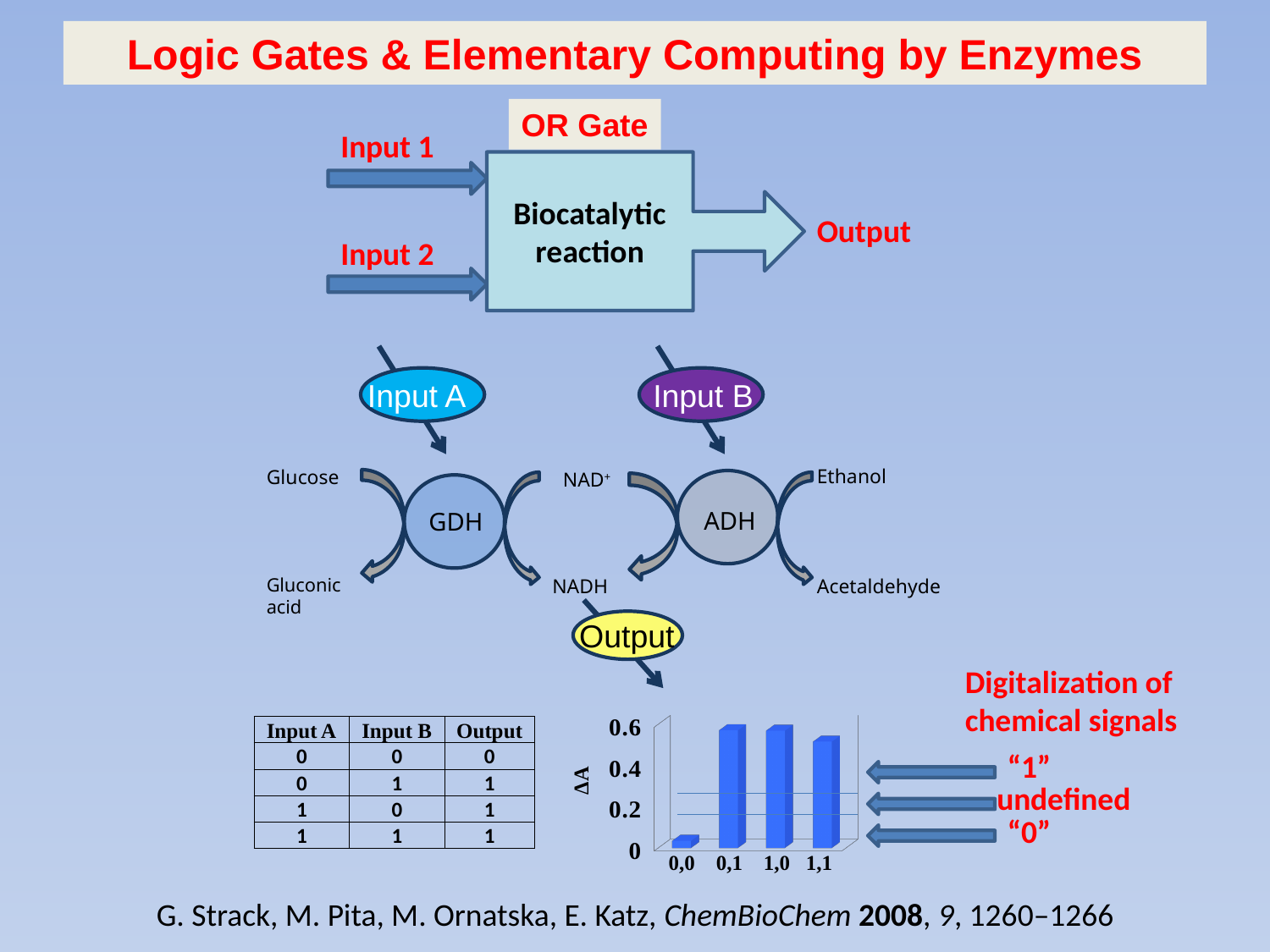
Which category has the lowest value in the bar chart? 0,0 Is the value for 0,0 greater or less than 0.2? less What kind of chart is shown at the bottom of the slide? bar chart Is the value for 1,0 greater or less than 0.4? greater Is the value for 1,1 greater or less than 0.4? greater Which is larger in the bar chart, the value for 0,0 or the value for 0,1? 0,1 Which is larger in the bar chart, the value for 1,1 or the value for 0,0? 1,1 How many categories are plotted on the x axis of the bar chart? 4 What is the highest tick value shown on the y axis of the bar chart? 0.6 What is the label on the y axis of the bar chart? ΔA